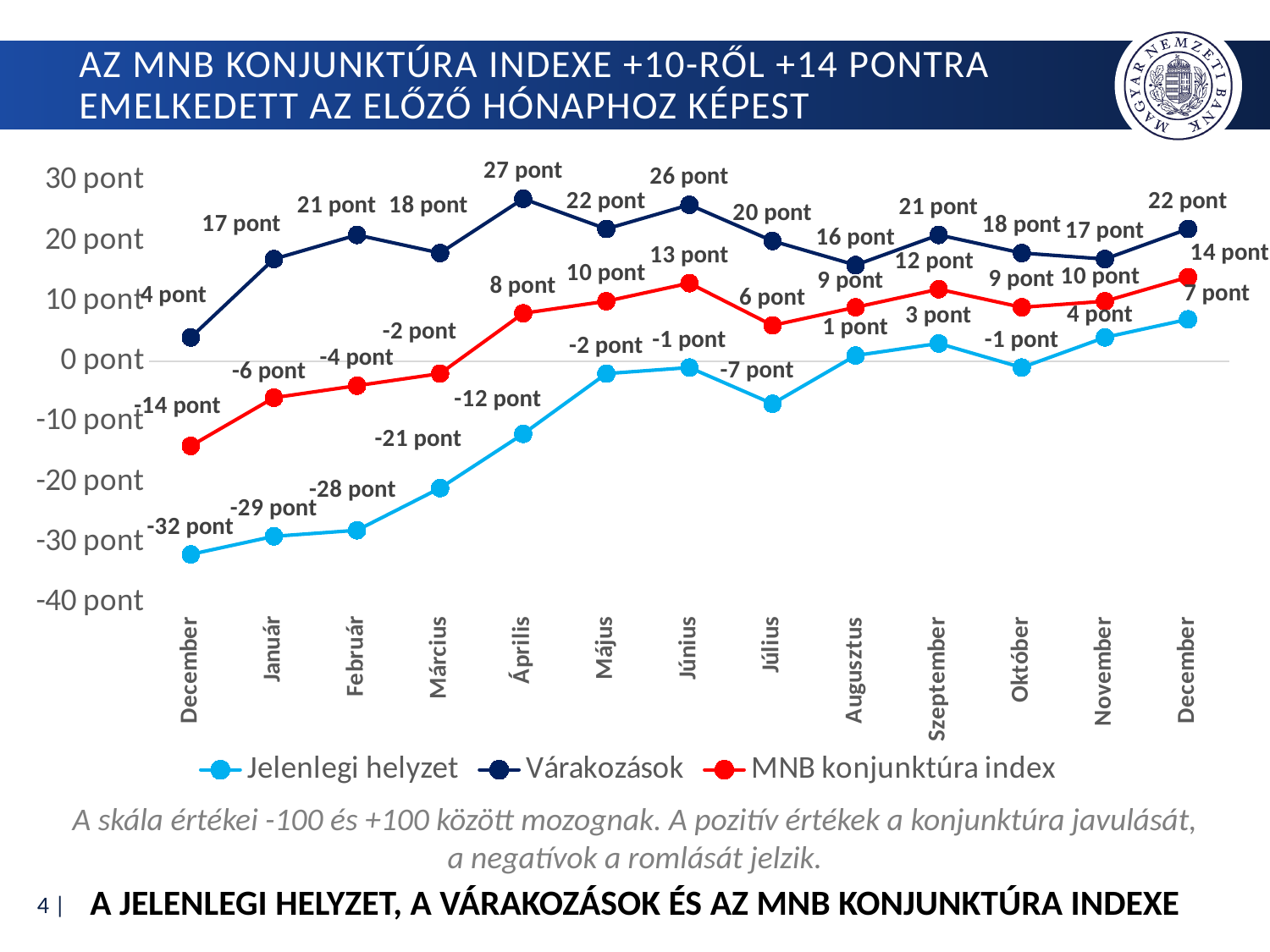
In which month does Várakozások reach its highest value? Április How many series does the legend list? 3 Which is larger for Jelenlegi helyzet: the value in Augusztus or in Szeptember? Szeptember What is the difference between Várakozások and the MNB konjunktúra index in Július? 14 pont Does Jelenlegi helyzet generally rise or fall from the first December to the last December? rise What is the value of Jelenlegi helyzet in Március? -21 pont What colour is the line for the MNB konjunktúra index? red What is the value of Várakozások in Április? 27 pont How many months are plotted along the x axis? 13 In which month is Jelenlegi helyzet at its lowest value? December (the first one, on the left) What is the value of the MNB konjunktúra index in Június? 13 pont What kind of chart is shown on the slide? line chart